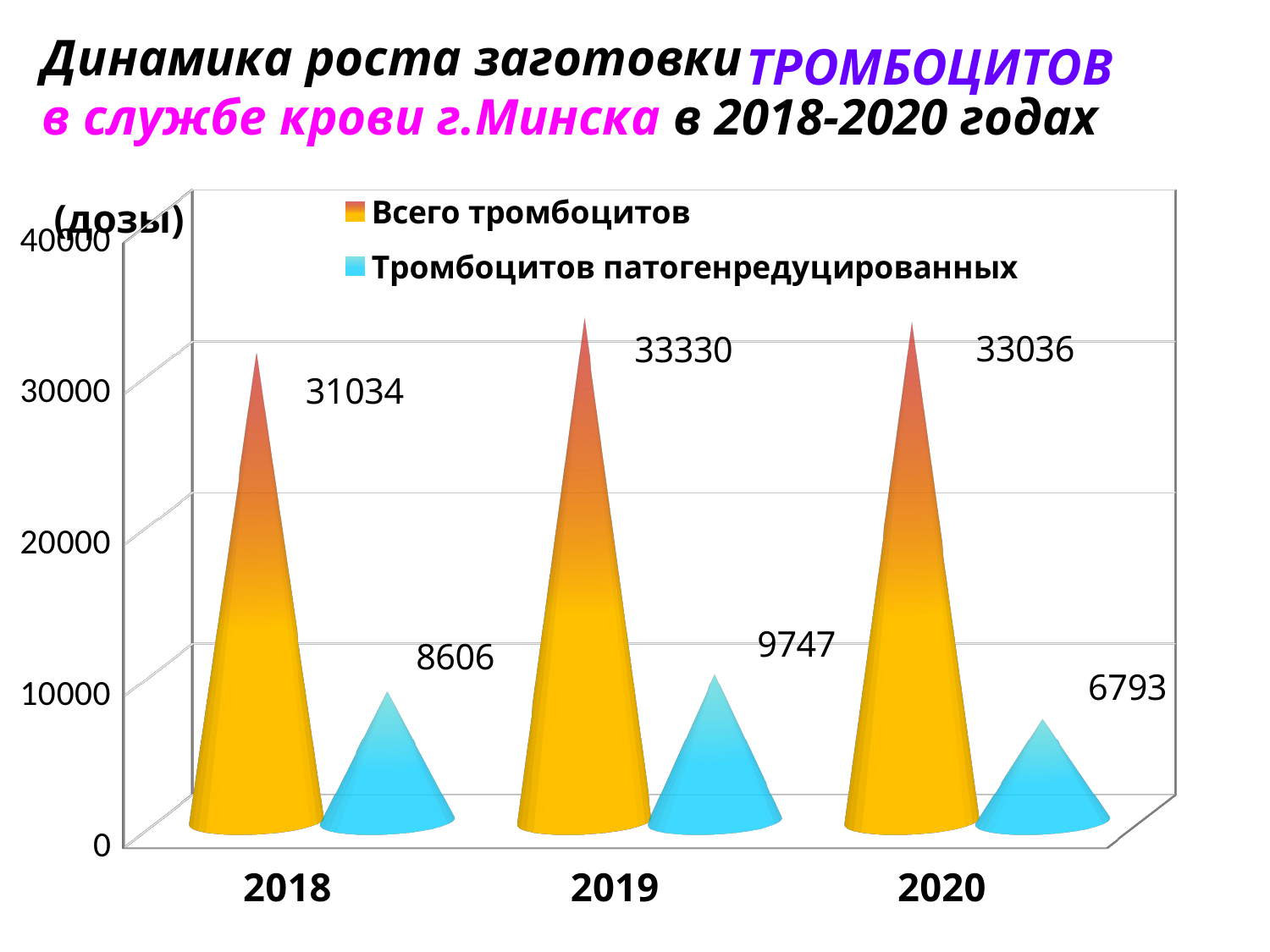
What is the value for 'Всего тромбоцитов' in 2019? 33330 Which year has the lowest value for 'Тромбоцитов патогенредуцированных'? 2020 Is the value for 'Всего тромбоцитов' in 2020 greater or less than 30000? greater How many years are shown on the x axis? 3 What kind of chart is shown on the slide? bar chart Which year has the highest value for 'Всего тромбоцитов'? 2019 What is the difference between 'Тромбоцитов патогенредуцированных' in 2019 and in 2020? 2954 How many series does the legend list? 2 Which is larger: 'Тромбоцитов патогенредуцированных' in 2018 or in 2019? 2019 What is the difference between 'Всего тромбоцитов' in 2019 and in 2018? 2296 What is the value for 'Всего тромбоцитов' in 2018? 31034 What is the value for 'Тромбоцитов патогенредуцированных' in 2020? 6793